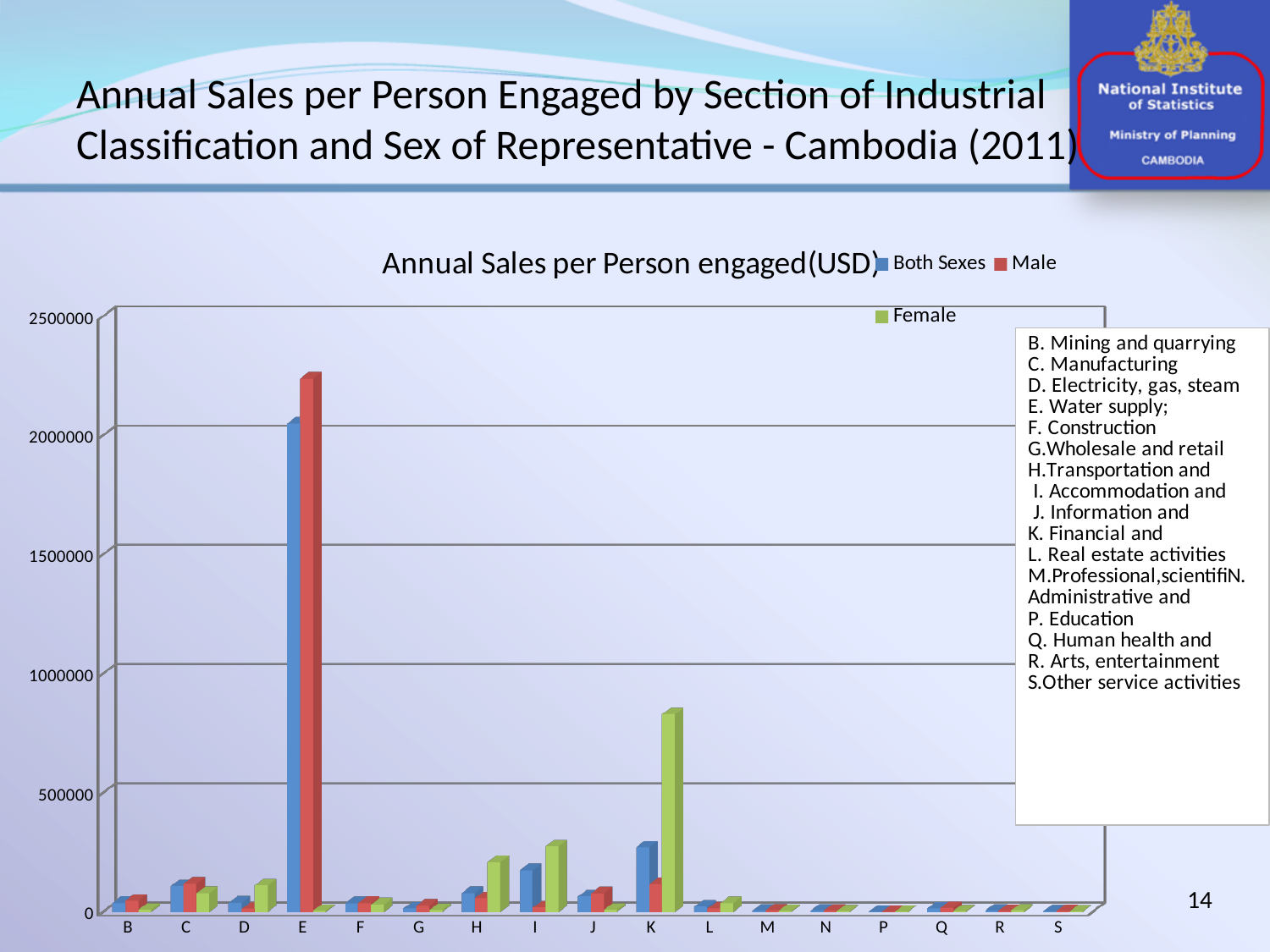
How many categories are shown along the x axis of the chart? 17 How many series does the chart's legend list? 3 For category K, which is larger: the Female value or the Male value? Female Is the Female value for K greater or less than 1000000? less For category E, which is larger: the Male value or the Female value? Male Is the Female value for K greater or less than 500000? greater Which category has the highest Both Sexes value? E What is the title of the chart? Annual Sales per Person engaged(USD) Which category has the highest Female value? K What kind of chart is shown on the slide? bar chart Is the Male value for E greater or less than 2000000? greater Which category has the highest Male value? E